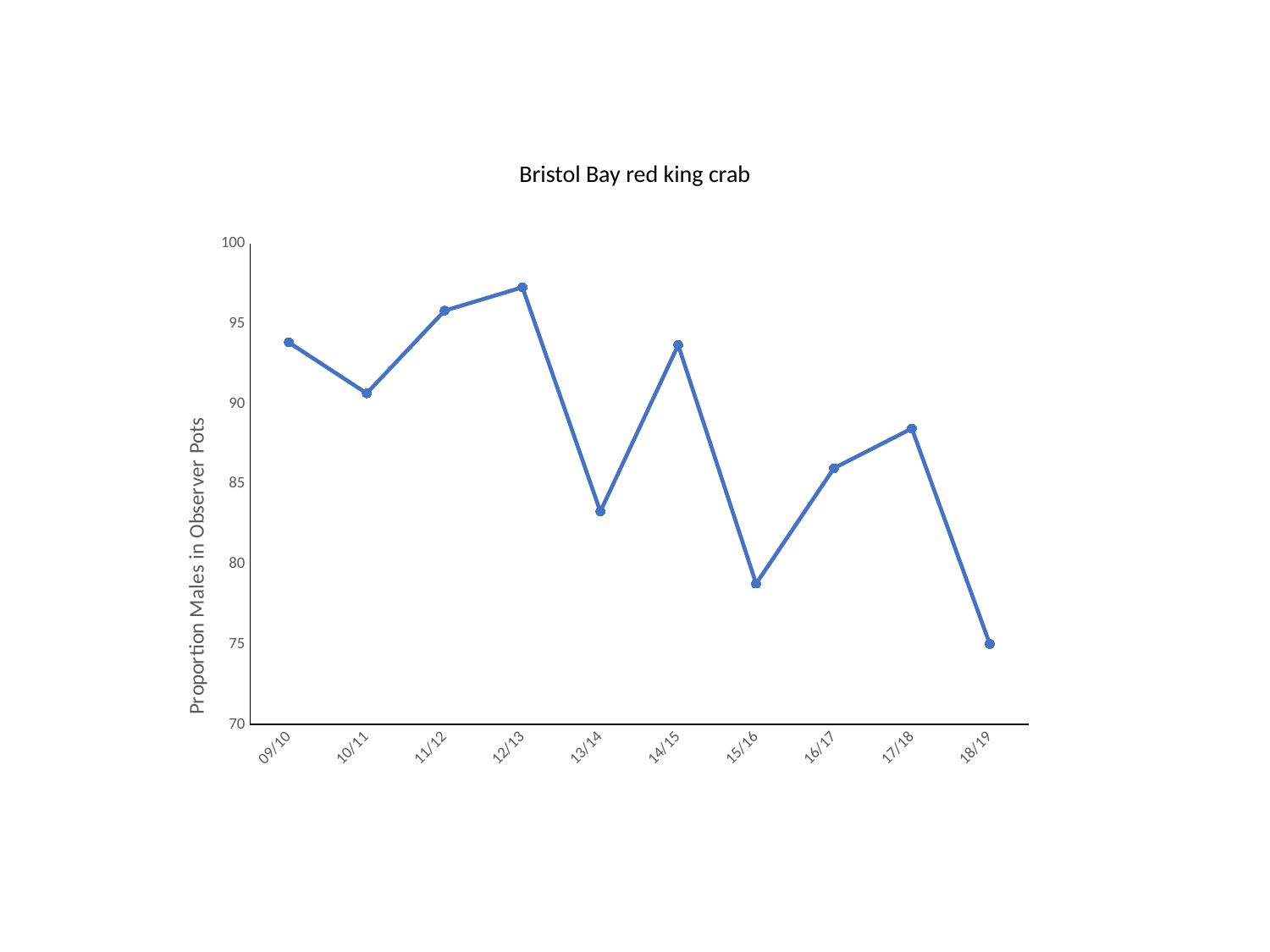
Which season has the larger value, 11/12 or 14/15? 11/12 Which season has the larger value, 13/14 or 16/17? 16/17 Is the value for 12/13 greater or less than 95? greater What is the label of the vertical axis? Proportion Males in Observer Pots Is the value for 13/14 greater or less than 85? less Which season has the lowest proportion of males in observer pots? 18/19 What is the title of the chart? Bristol Bay red king crab How many seasons are plotted along the x axis? 10 Which season has the highest proportion of males in observer pots? 12/13 Overall, do the values rise or fall from 09/10 to 18/19? fall What kind of chart is shown on the slide? line chart Is the value for 15/16 greater or less than 80? less